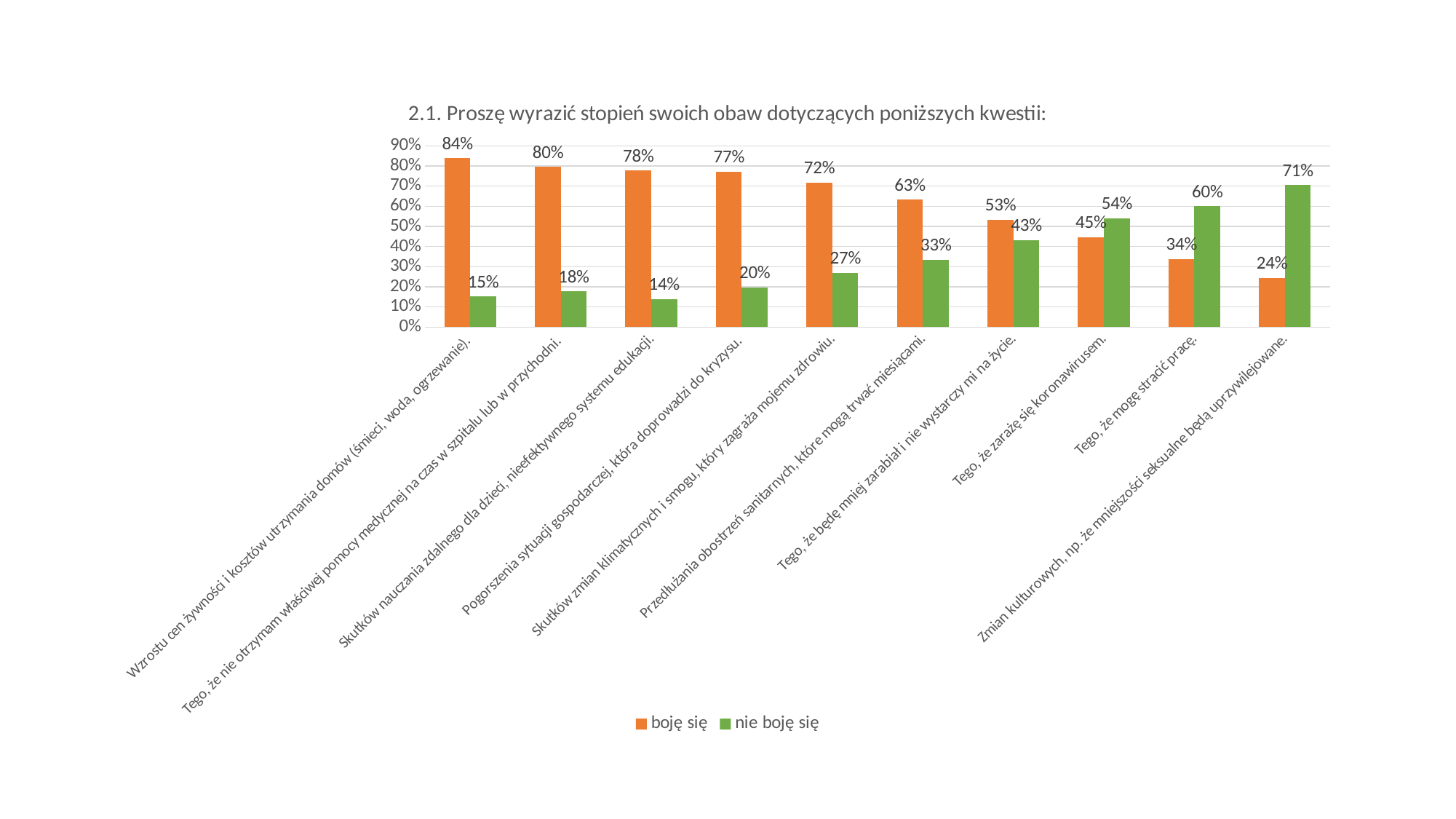
Do the 'boję się' values rise or fall from left to right along the x axis? fall How many categories are shown on the x axis? 10 What is the 'boję się' value for 'Wzrostu cen żywności i kosztów utrzymania domów (śmieci, woda, ogrzewanie).'? 84% What type of chart is shown on the slide? bar chart What is the 'boję się' value for 'Tego, że zarażę się koronawirusem.'? 45% What is the difference between the 'boję się' and 'nie boję się' values for 'Przedłużania obostrzeń sanitarnych, które mogą trwać miesiącami.'? 30% What colour are the 'nie boję się' bars? green What is the 'nie boję się' value for 'Tego, że mogę stracić pracę.'? 60% For 'Tego, że będę mniej zarabiał i nie wystarczy mi na życie.', which is larger: 'boję się' or 'nie boję się'? boję się Which category has the highest 'nie boję się' value? Zmian kulturowych, np. że mniejszości seksualne będą uprzywilejowane. How many series does the legend list? 2 Which category has the lowest 'boję się' value? Zmian kulturowych, np. że mniejszości seksualne będą uprzywilejowane.